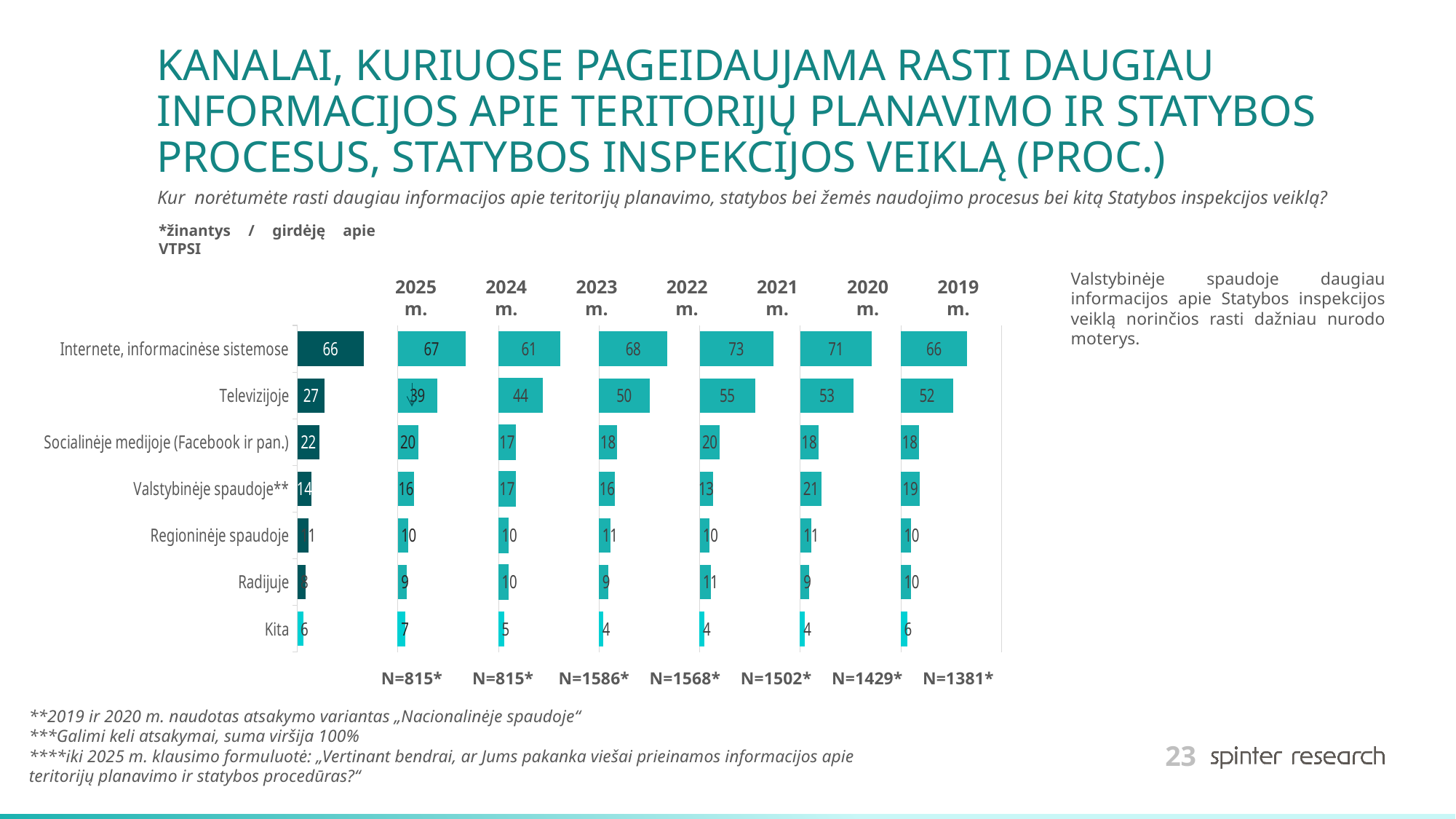
What kind of chart is used on this slide? Bar chart In the leftmost dark-coloured chart, which category has the highest value? Internete, informacinėse sistemose In the rightmost chart, which category has the lowest value? Kita Which category label on the vertical axis is marked with two asterisks? Valstybinėje spaudoje** In the leftmost dark-coloured chart, what is the difference between the values for Internete, informacinėse sistemose and Televizijoje? 39 Across all the charts on the slide, what is the highest value shown for Internete, informacinėse sistemose? 73 In the leftmost dark-coloured chart, what is the value for Televizijoje? 27 In the leftmost dark-coloured chart, what is the value for Internete, informacinėse sistemose? 66 In the second chart from the left, what is the value for Kita? 7 In the second chart from the left, which is larger: Televizijoje or Socialinėje medijoje (Facebook ir pan.)? Televizijoje In the rightmost chart, what is the value for Televizijoje? 52 How many categories are listed on the vertical axis of the charts? 7